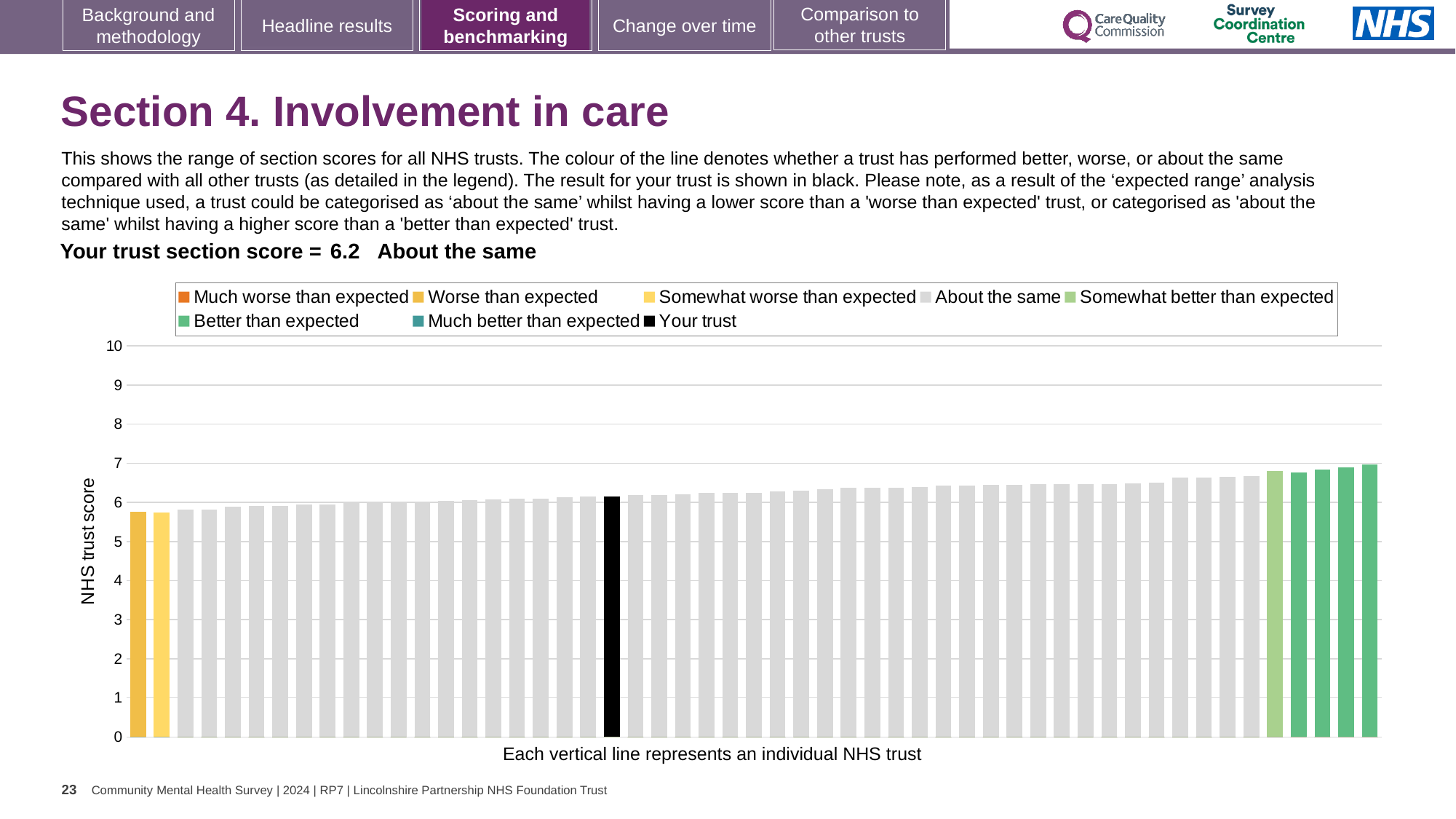
Is the value of the leftmost bar greater or less than 6? less Is the value of the tallest bar (rightmost) greater or less than 6? greater How many bars are coloured as 'Worse than expected' (yellow)? 1 What kind of chart is shown on the slide? bar chart What is the section score for your trust shown on the slide? 6.2 Is the value for your trust (the black bar) greater or less than 5? greater Which category is your trust placed in for Section 4. Involvement in care? About the same Do the bar values rise or fall moving from left to right along the x axis? rise Which bar is taller: the leftmost bar or the rightmost bar? the rightmost bar How many entries does the chart legend list? 8 What colour is used for the bar representing your trust? black What is the label on the vertical axis of the chart? NHS trust score